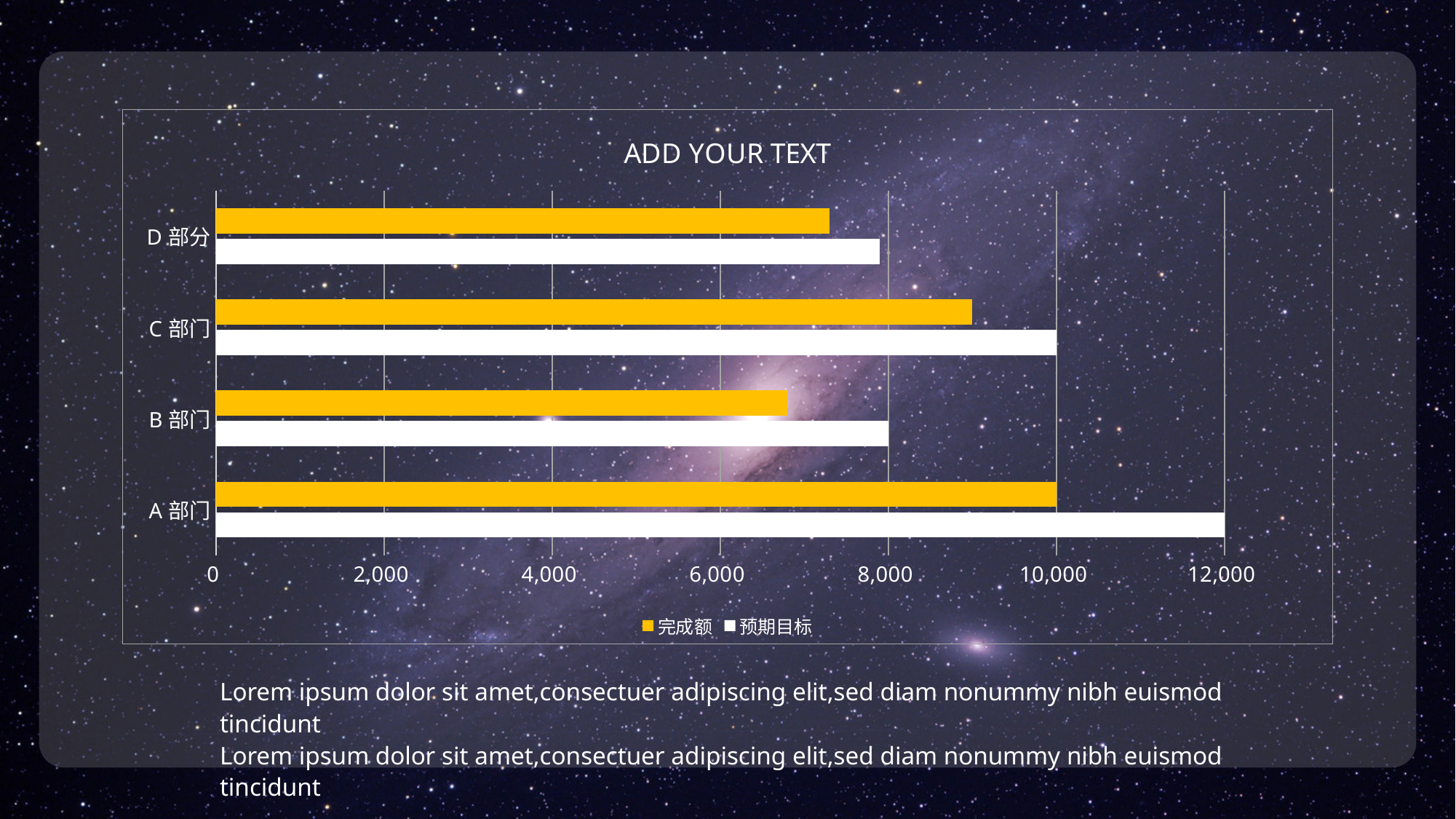
What is the title of the chart? ADD YOUR TEXT How many series does the legend list? 2 How many categories are shown on the chart? 4 What kind of chart is shown on the slide? bar chart Is the 完成额 value for C 部门 greater or less than 8,000? greater Is the 完成额 value for D 部分 greater or less than 8,000? less Which category has the highest 预期目标 value? A 部门 Which category has the lowest 完成额 value? B 部门 Which is larger, the 完成额 value for C 部门 or the 完成额 value for D 部分? C 部门 What is the 预期目标 value for C 部门? 10,000 What is the 预期目标 value for A 部门? 12,000 Which series is drawn in yellow? 完成额